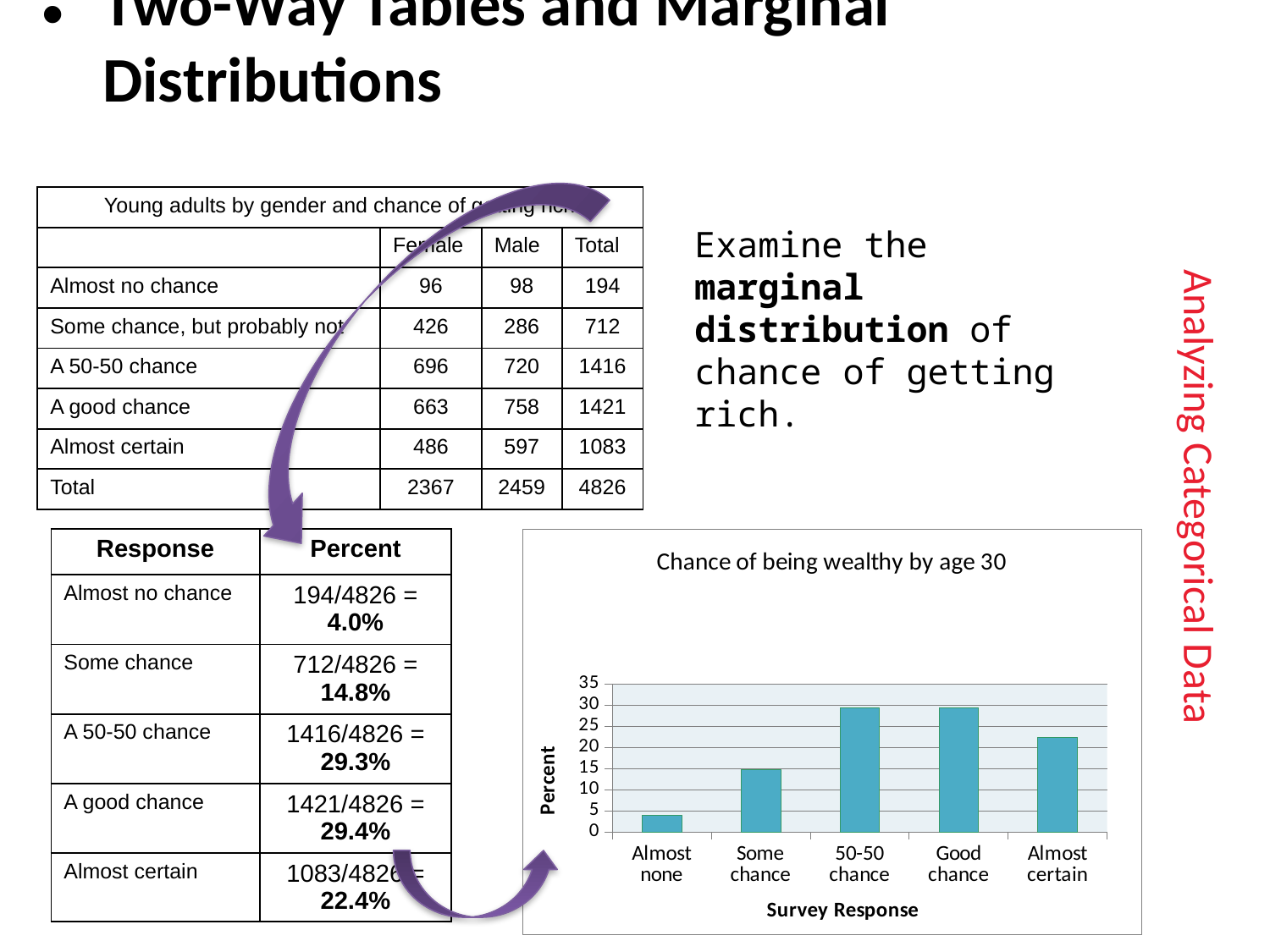
Which survey response has the lowest bar in the chart? Almost none Is the value for Some chance greater or less than 10? greater Is the value for 50-50 chance greater or less than 25? greater Which is larger in the chart, the value for Almost certain or the value for Some chance? Almost certain What is the label on the vertical axis of the chart? Percent How many survey response categories are plotted in the chart? 5 Which is larger in the chart, the value for Good chance or the value for Almost certain? Good chance What is the title of the chart? Chance of being wealthy by age 30 Is the value for Almost certain greater or less than 20? greater What kind of chart is shown on the slide? bar chart